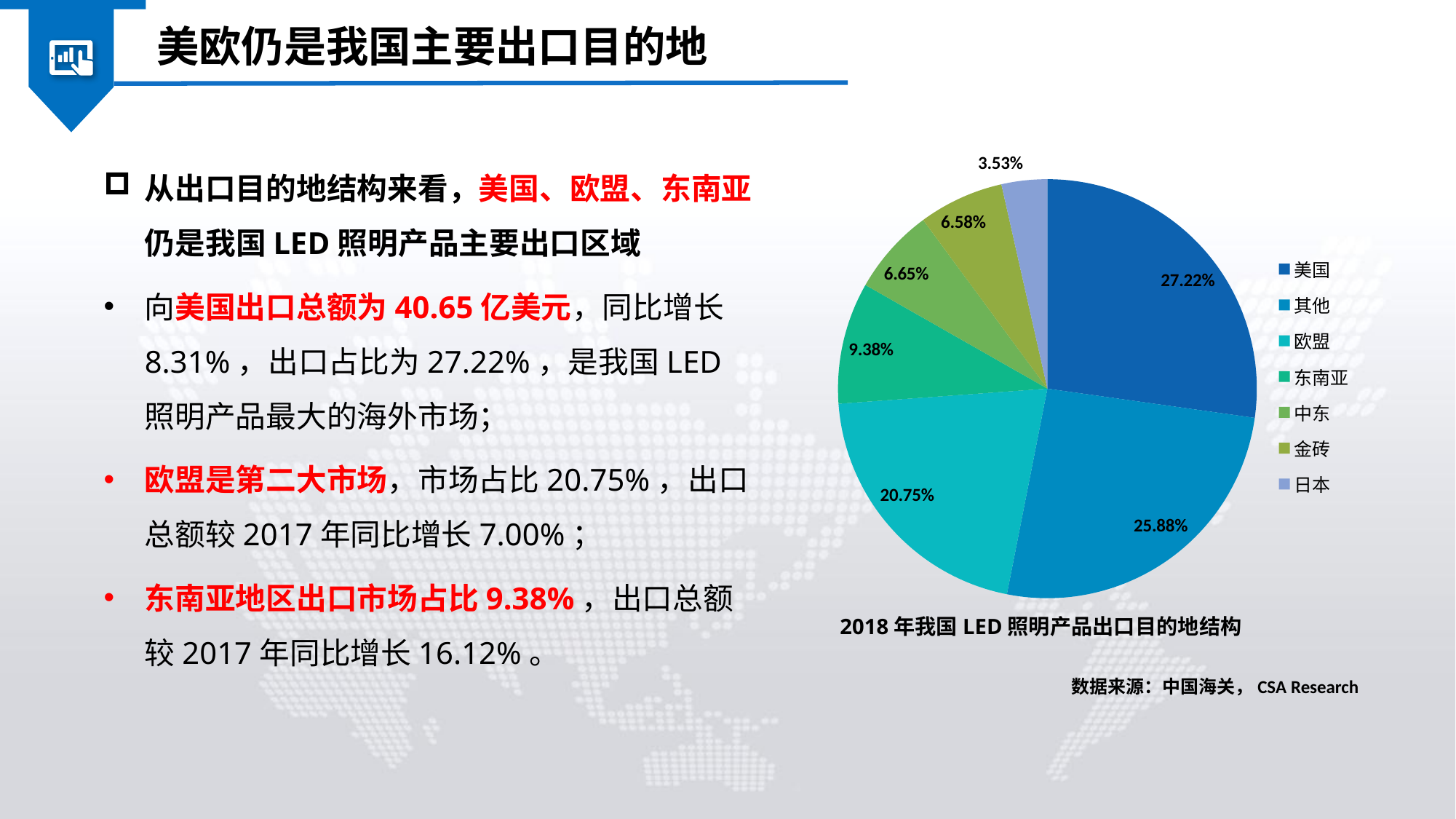
What share of the pie does 日本 hold? 3.53% What share of the pie does 东南亚 hold? 9.38% Which slice is larger, 其他 or 欧盟? 其他 What is the title of the pie chart? 2018年我国LED照明产品出口目的地结构 What is the difference in percentage points between the 美国 slice and the 欧盟 slice? 6.47 Which category has the largest slice of the pie? 美国 Which category has the smallest slice of the pie? 日本 What share of the pie does 欧盟 hold? 20.75% How many slices does the pie chart have? 7 What share of the pie does 其他 hold? 25.88% What share of the pie does 美国 hold? 27.22% What kind of chart is shown on the slide? Pie chart